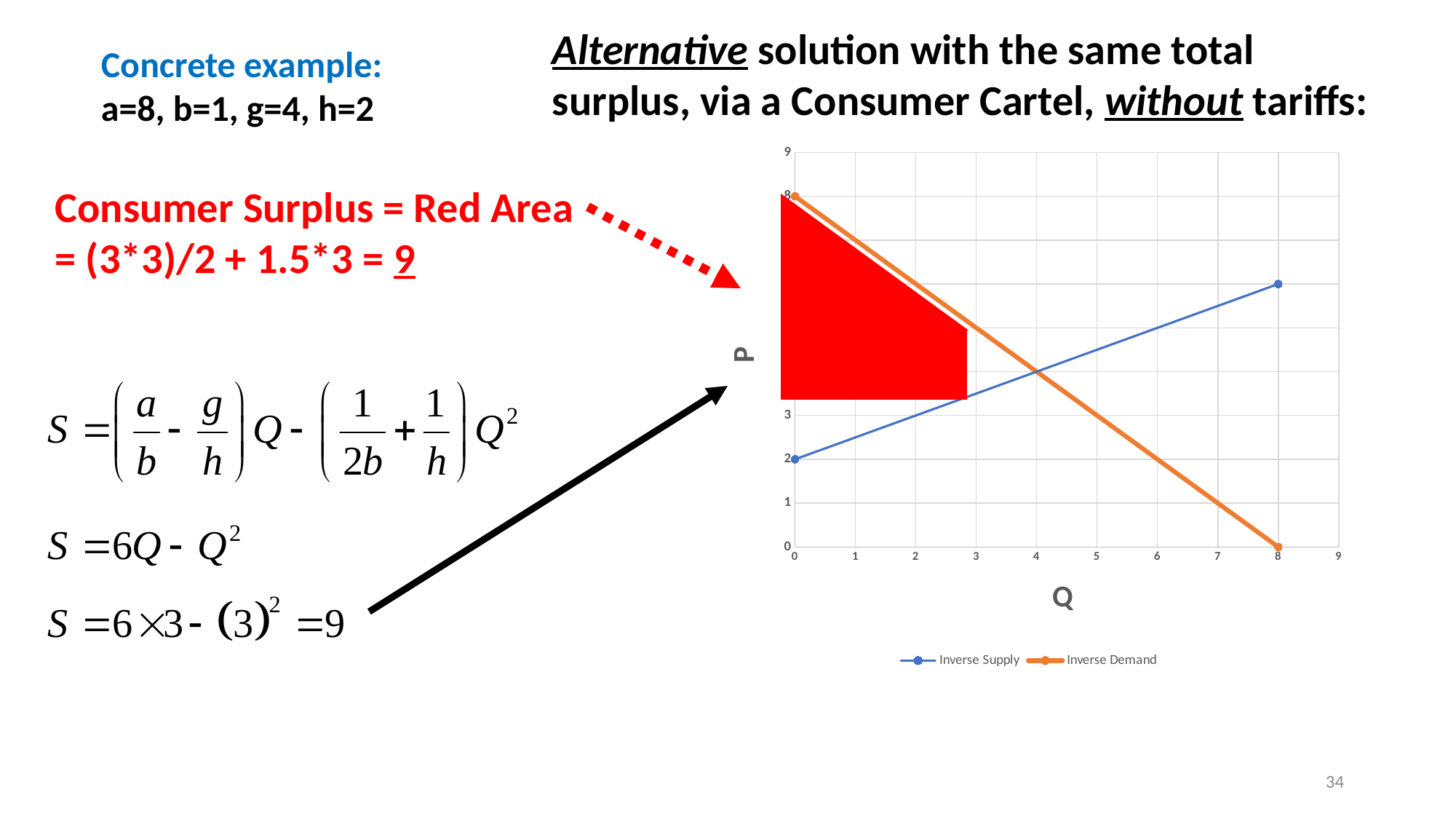
What is the difference between Inverse Demand and Inverse Supply at Q = 0? 6 What is the value of Inverse Demand at Q = 8? 0 What are the two series named in the chart legend? Inverse Supply and Inverse Demand At Q = 0, which series has the higher value, Inverse Supply or Inverse Demand? Inverse Demand What is the value of Inverse Supply at Q = 0? 2 Does the Inverse Supply line rise or fall as Q increases? rise What label is shown on the horizontal axis of the chart? Q What is the value of Inverse Supply at Q = 8? 6 How many series does the chart legend list? 2 What kind of chart is shown on the slide? line chart Does the Inverse Demand line rise or fall as Q increases? fall What is the value of Inverse Demand at Q = 0? 8